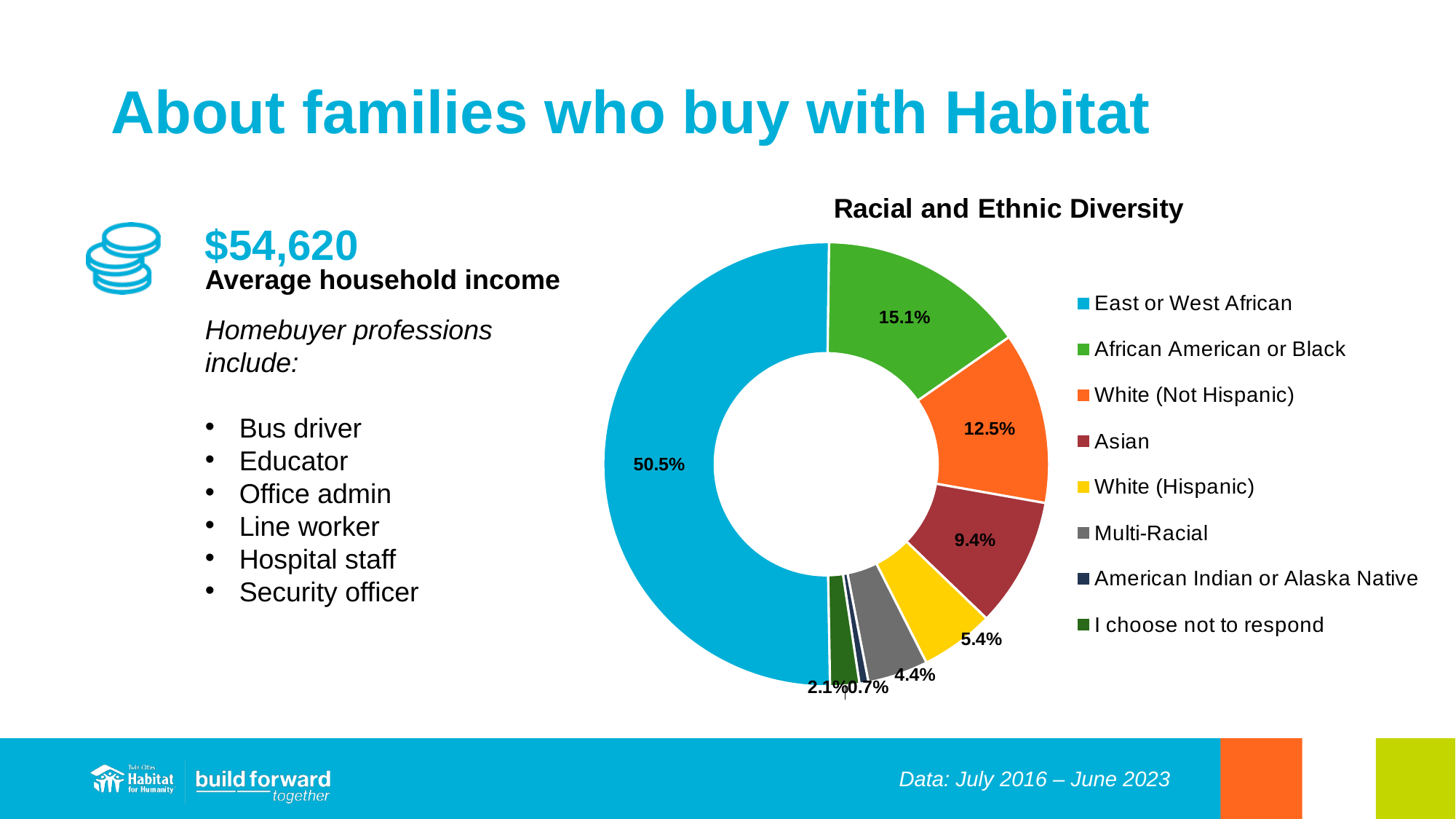
What is the difference in percentage points between African American or Black and White (Not Hispanic)? 2.6 What percentage is shown for African American or Black in the Racial and Ethnic Diversity chart? 15.1% What is the value for Asian in the Racial and Ethnic Diversity chart? 9.4% What share of the Racial and Ethnic Diversity chart is East or West African? 50.5% What colour represents Asian in the Racial and Ethnic Diversity chart? Dark red Which category has the smallest share in the Racial and Ethnic Diversity chart? American Indian or Alaska Native How many categories does the legend of the Racial and Ethnic Diversity chart list? 8 Which is larger in the Racial and Ethnic Diversity chart: White (Hispanic) or Multi-Racial? White (Hispanic) What percentage does the Multi-Racial slice represent? 4.4% What type of chart is shown under the title "Racial and Ethnic Diversity"? Doughnut chart Which category has the largest share in the Racial and Ethnic Diversity chart? East or West African What percentage is shown for White (Not Hispanic)? 12.5%